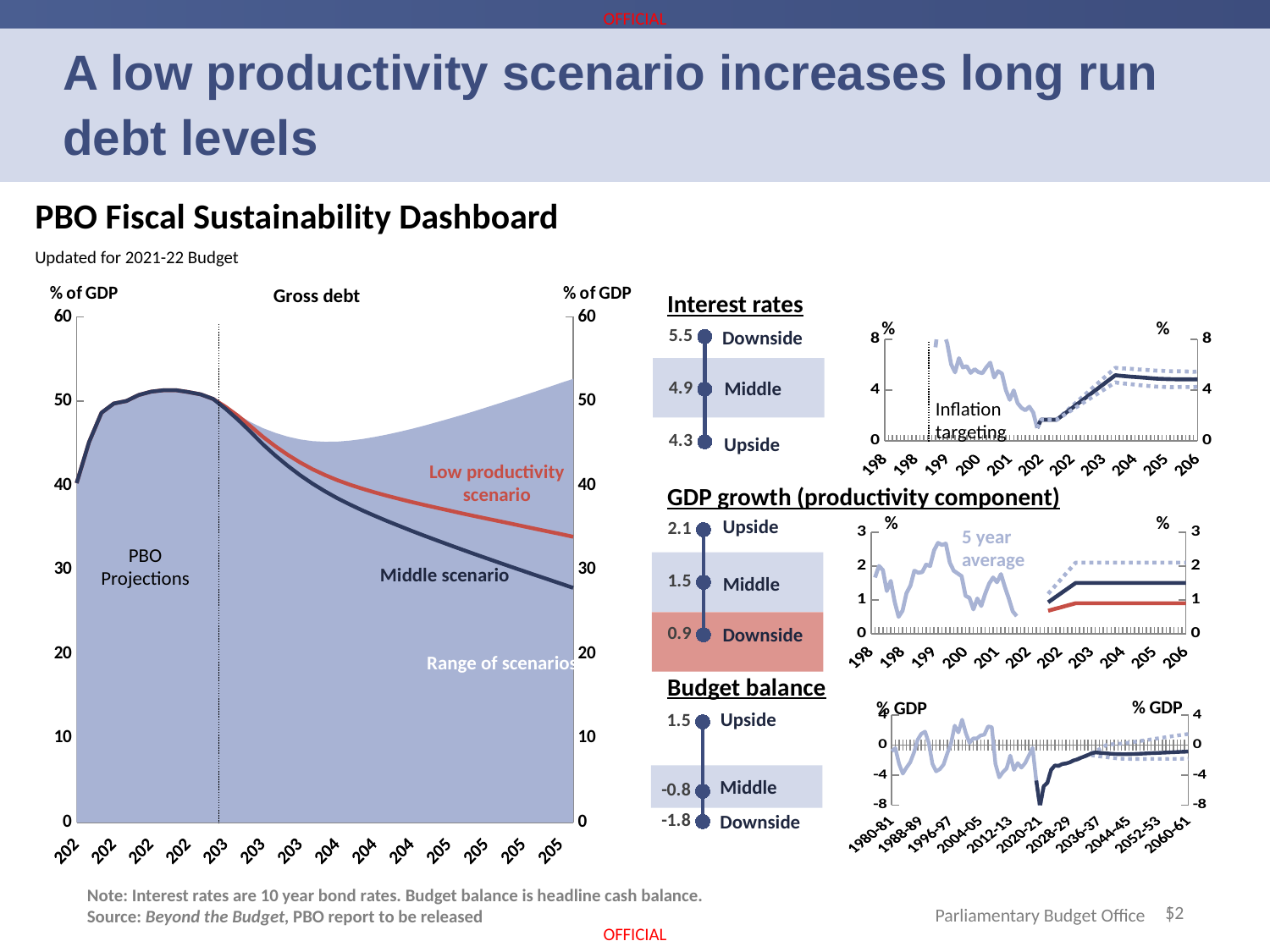
In the Gross debt chart, does the Middle scenario rise or fall after the PBO Projections line? fall In the Interest rates panel, what value is shown for the Downside scenario? 5.5 In the Gross debt chart, is the final value of the Middle scenario greater or less than 30? less In the Gross debt chart, which scenario ends higher at the right-hand side: the Low productivity scenario or the Middle scenario? Low productivity scenario What is the title of the large chart on the left of the slide? Gross debt What kind of chart is the Gross debt chart? combination area and line chart In the Interest rates panel, what value is shown for the Upside scenario? 4.3 In the GDP growth (productivity component) panel, what value is shown for the Middle scenario? 1.5 In the Gross debt chart, is the final value of the Low productivity scenario greater or less than 30? greater In the Gross debt chart, is the peak value of gross debt greater or less than 50? greater In the Gross debt chart, what unit is shown on the vertical axis? % of GDP In the Budget balance panel, what value is shown for the Downside scenario? -1.8